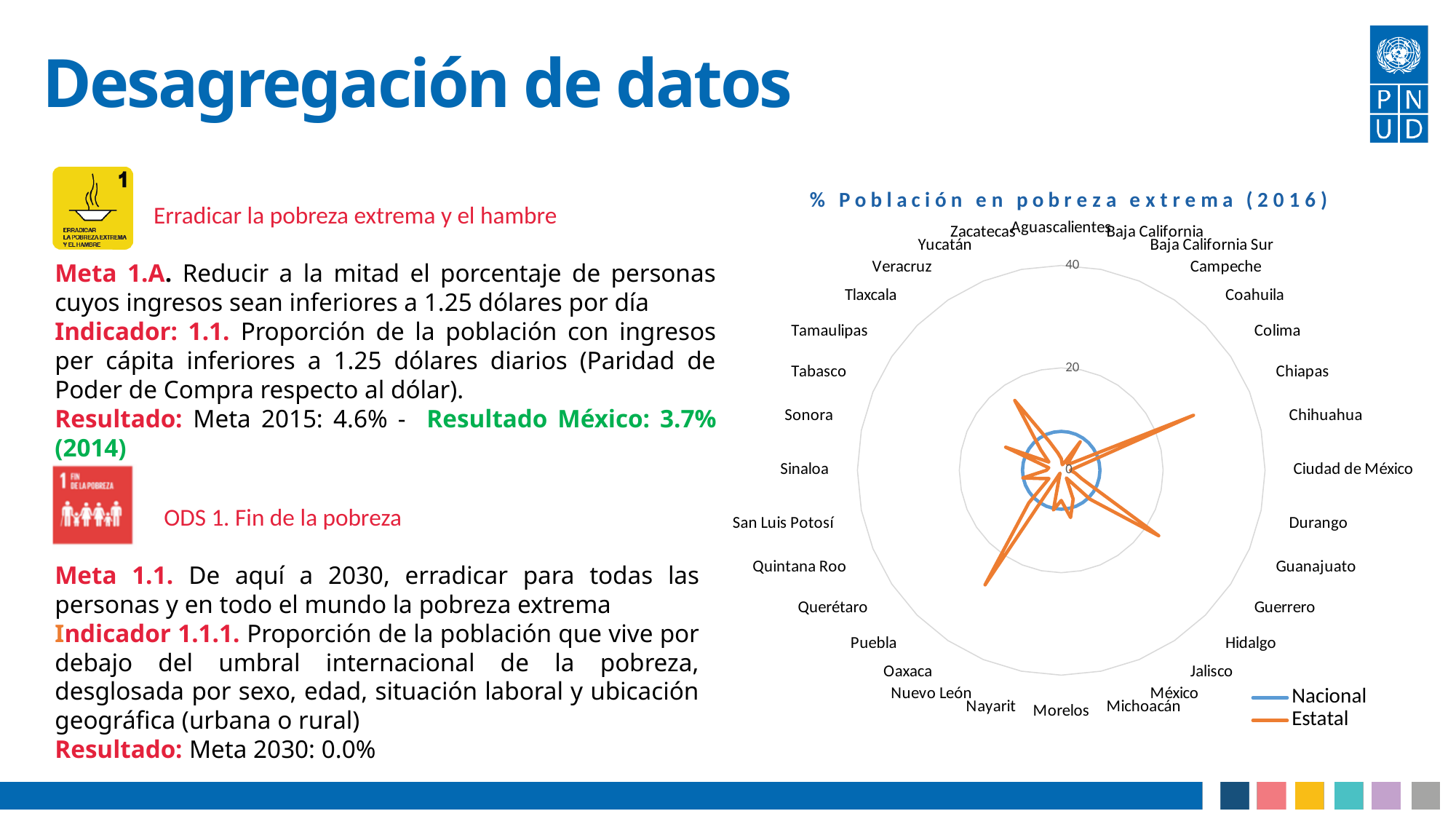
Is the Estatal value for Chiapas greater or less than 40? less What are the two series named in the chart legend? Nacional and Estatal What is the highest tick value shown on the radial axis of the chart? 40 What kind of chart is shown on the slide? Radar chart Is the Estatal value for Oaxaca greater or less than 20? greater Which has a larger Estatal value, Oaxaca or Baja California? Oaxaca What is the title of the chart? % Población en pobreza extrema (2016) Is the Nacional value greater or less than 20? less Which has a larger Estatal value, Chiapas or Nuevo León? Chiapas How many states (categories) are plotted around the radar chart? 32 How many series does the chart legend list? 2